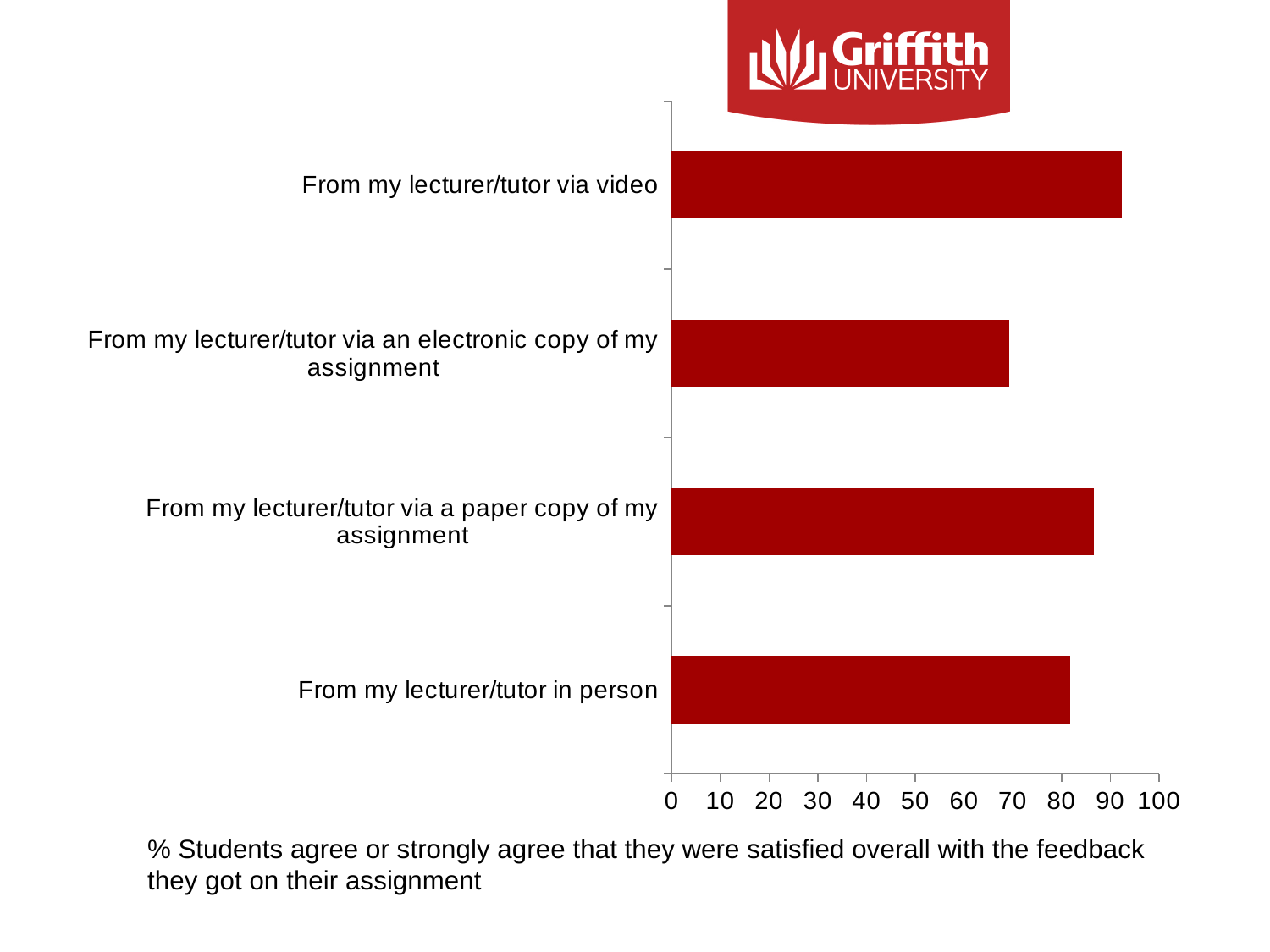
What kind of chart is shown on the slide? bar chart Is the value for 'From my lecturer/tutor via an electronic copy of my assignment' greater or less than 80? less Which feedback method has the highest percentage of students satisfied overall? From my lecturer/tutor via video According to the caption below the chart, what do the bars measure? % Students agree or strongly agree that they were satisfied overall with the feedback they got on their assignment Which is larger: the value for feedback via video or the value for feedback via a paper copy of the assignment? via video What is the maximum value shown on the horizontal axis of the chart? 100 Which feedback method has the lowest percentage of students satisfied overall? From my lecturer/tutor via an electronic copy of my assignment Is the value for 'From my lecturer/tutor via a paper copy of my assignment' greater or less than 90? less Which is larger: the value for feedback via a paper copy of the assignment or the value for feedback in person? via a paper copy of my assignment How many categories (feedback methods) are plotted in the chart? 4 Is the value for 'From my lecturer/tutor via video' greater or less than 80? greater